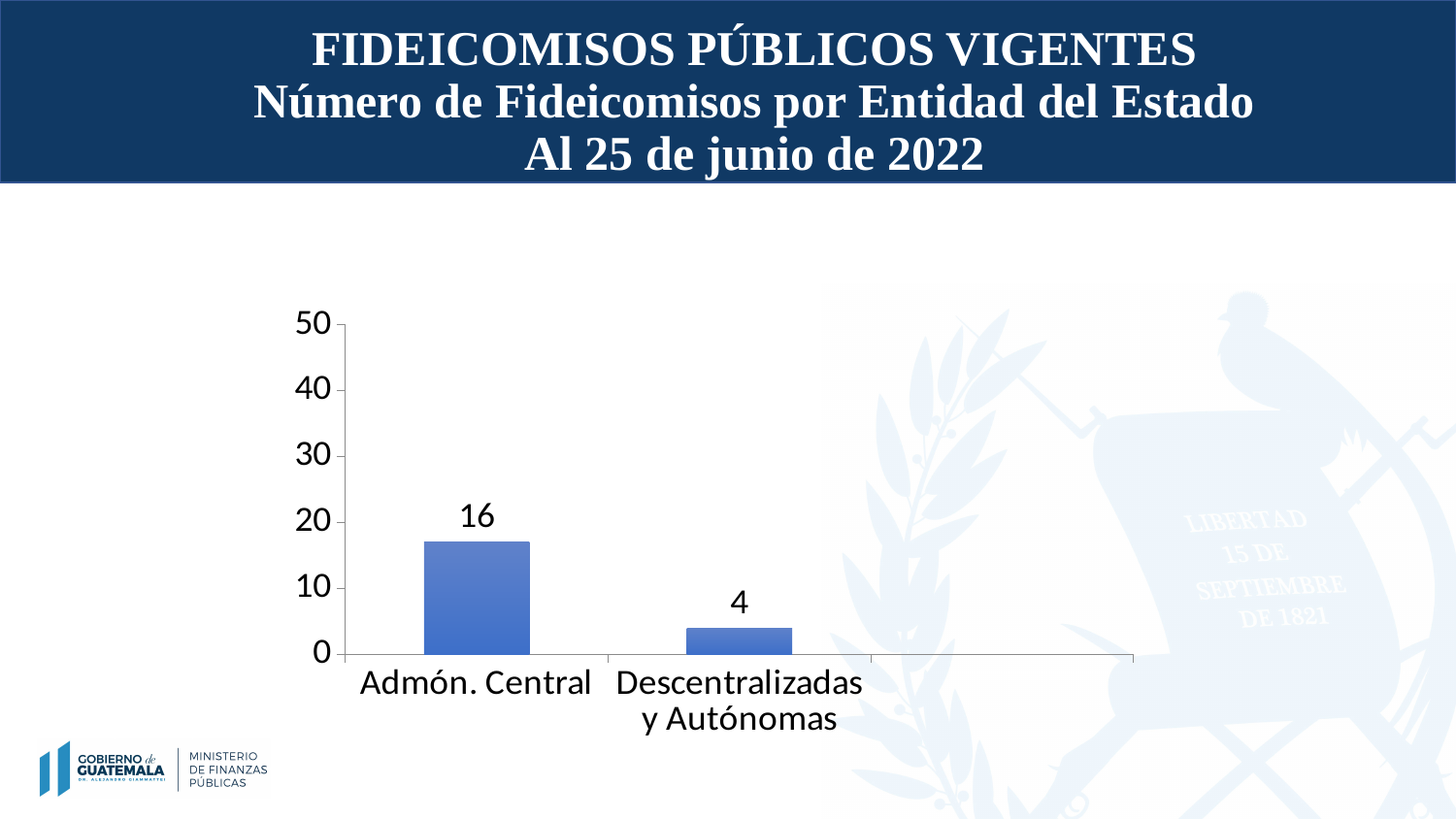
How many categories are shown on the x axis? 2 What is the difference between the values for Admón. Central and Descentralizadas y Autónomas? 12 Which category has the highest value? Admón. Central Which category has the lowest value? Descentralizadas y Autónomas What is the highest value shown on the y axis? 50 What kind of chart is shown on the slide? bar chart Is the value for Descentralizadas y Autónomas greater or less than 10? less What is the total of the two bars shown? 20 Is the value for Admón. Central greater or less than 20? less What is the value for Admón. Central? 16 What is the value for Descentralizadas y Autónomas? 4 Which is larger, the value for Admón. Central or the value for Descentralizadas y Autónomas? Admón. Central